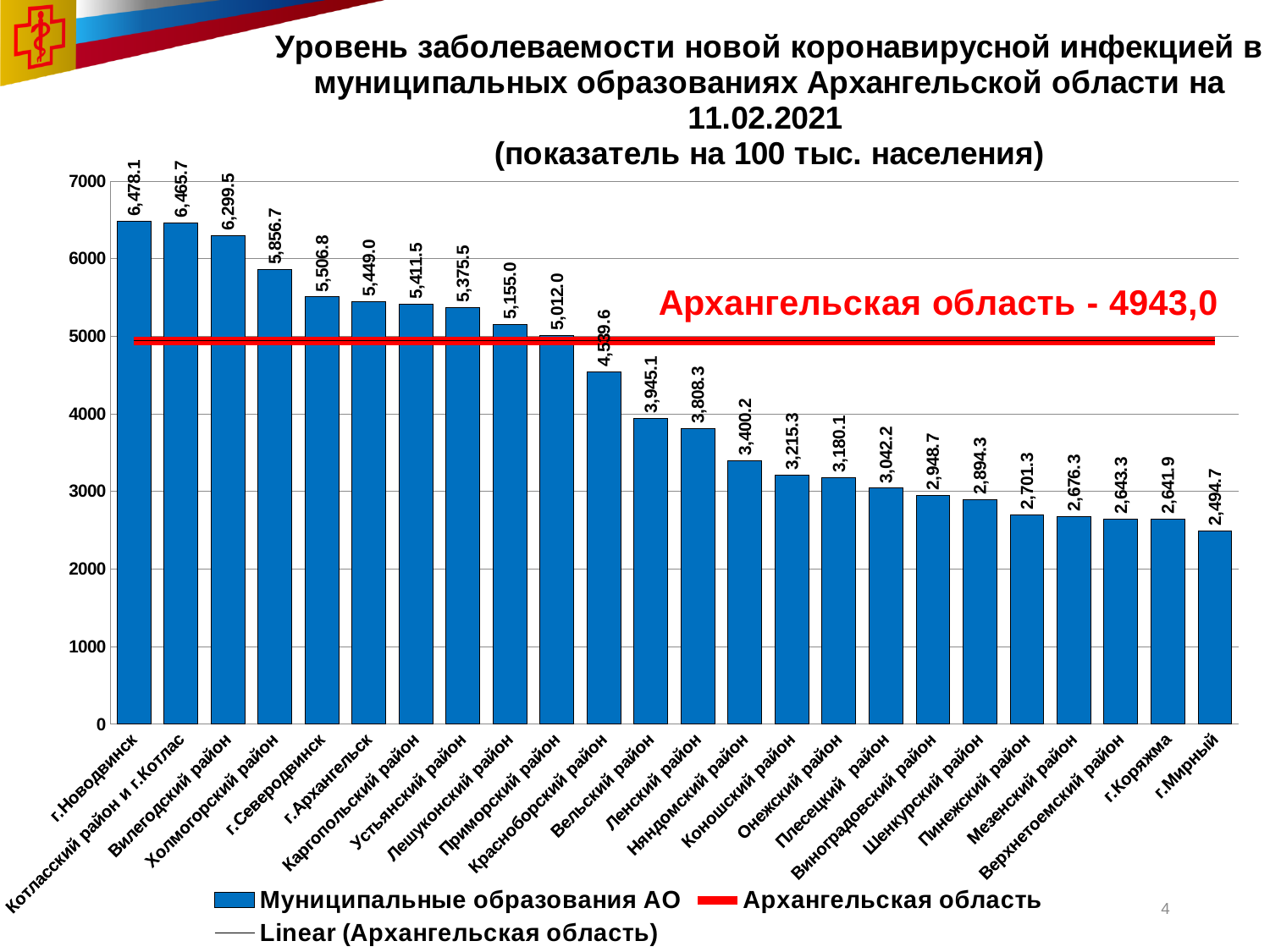
What is the value for г.Новодвинск? 6,478.1 What is the value for Вельский район? 3,945.1 Which is larger, the value for Холмогорский район or the value for г.Северодвинск? Холмогорский район How many entries does the legend list? 3 What value is shown for Архангельская область by the red line? 4943,0 Is the value for Красноборский район greater or less than 5000? less What is the value for г.Коряжма? 2,641.9 How many municipalities are shown on the chart? 24 Which municipality has the highest value? г.Новодвинск What is the difference between the values for Вельский район and Ленский район? 136.8 Which municipality has the lowest value? г.Мирный What is the difference between the values for г.Новодвинск and г.Мирный? 3,983.4